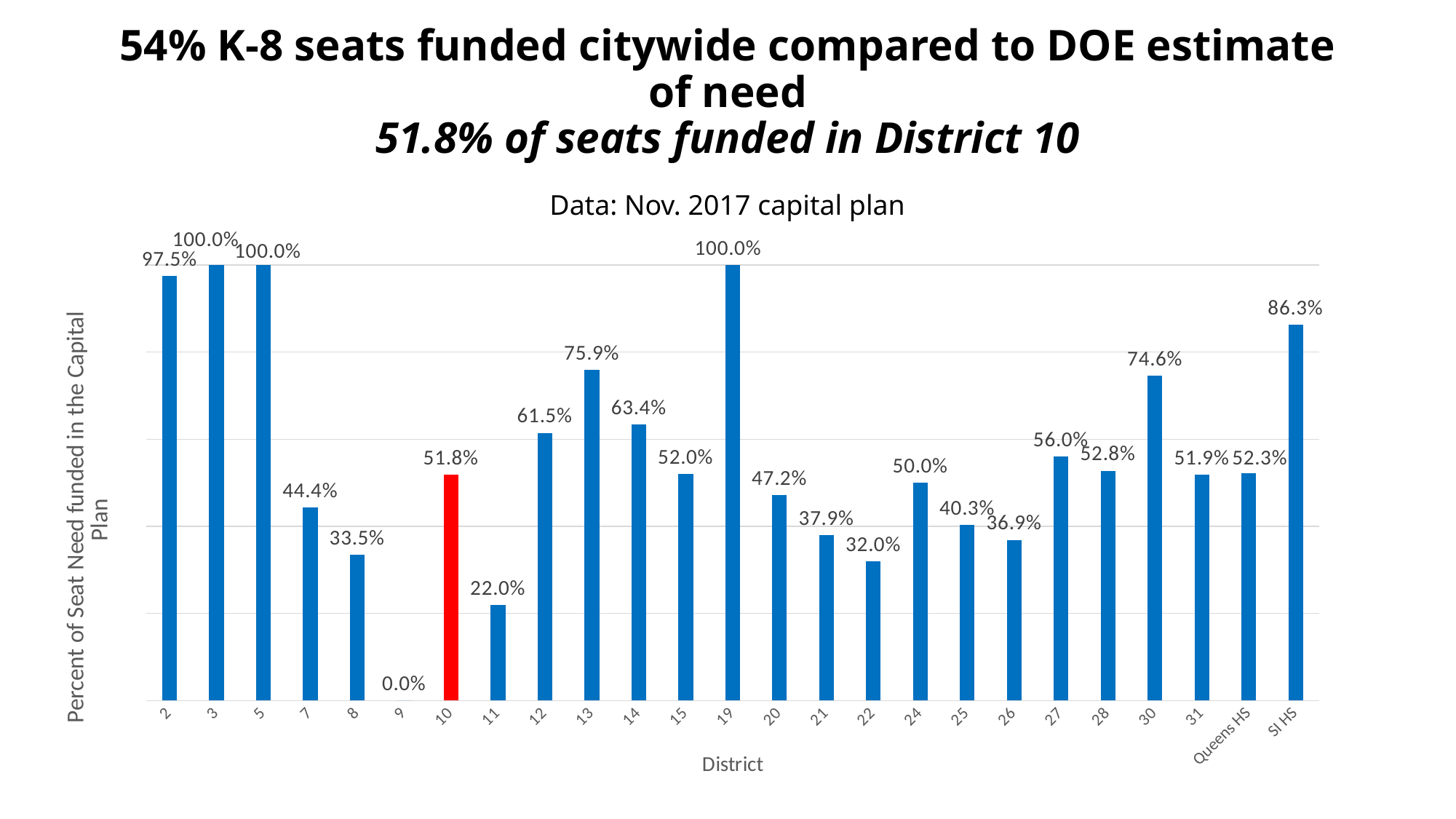
What kind of chart is shown on the slide? Bar chart What is the value for District 13? 75.9% Which is larger, the value for District 12 or the value for District 14? District 14 Which district has the lowest percent of seat need funded? 9 What is the value for SI HS? 86.3% How many categories are shown on the x axis? 25 Which is larger, the value for District 8 or the value for District 22? District 8 What is the difference between the values for SI HS and Queens HS? 34.0% What is the value for District 9? 0.0% What is the difference between the values for District 30 and District 11? 52.6% Which district's bar is coloured red? 10 What is the value for District 10? 51.8%